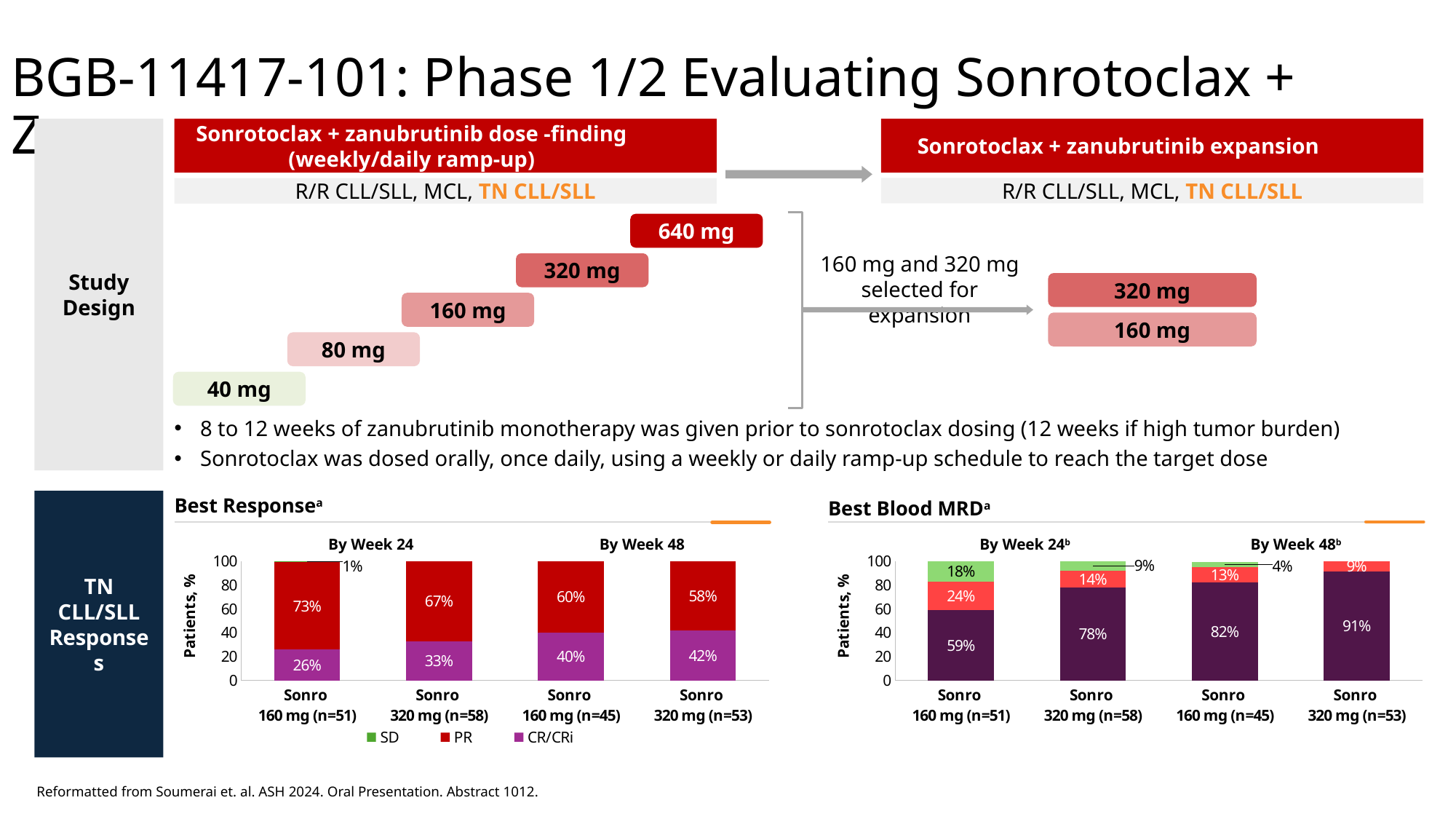
In the Best Blood MRD chart, which bar has the larger bottom (dark purple) segment by Week 48: Sonro 160 mg (n=45) or Sonro 320 mg (n=53)? Sonro 320 mg (n=53) In the Best Response chart, what is the CR/CRi percentage for Sonro 160 mg (n=51) by Week 24? 26% In the Best Response chart, what is the PR percentage for Sonro 320 mg (n=53) by Week 48? 58% How many series does the legend of the Best Response chart list? 3 In the Best Blood MRD chart, what is the value of the bottom (dark purple) segment for Sonro 320 mg (n=53) by Week 48? 91% How many bars are shown in the Best Blood MRD chart? 4 In the Best Response chart, what is the difference in PR percentage between Sonro 160 mg (n=51) and Sonro 320 mg (n=58) by Week 24? 6 percentage points In the Best Response chart, which bar has the highest CR/CRi percentage? Sonro 320 mg (n=53) by Week 48 In the Best Blood MRD chart, what is the difference between the bottom (dark purple) segments of Sonro 320 mg (n=58) and Sonro 160 mg (n=51) by Week 24? 19 percentage points In the Best Response chart, which has the larger CR/CRi share by Week 24: Sonro 160 mg (n=51) or Sonro 320 mg (n=58)? Sonro 320 mg (n=58) What kind of chart is the Best Response chart? Stacked bar chart In the Best Blood MRD chart, what is the value of the bottom (dark purple) segment for Sonro 160 mg (n=51) by Week 24? 59%